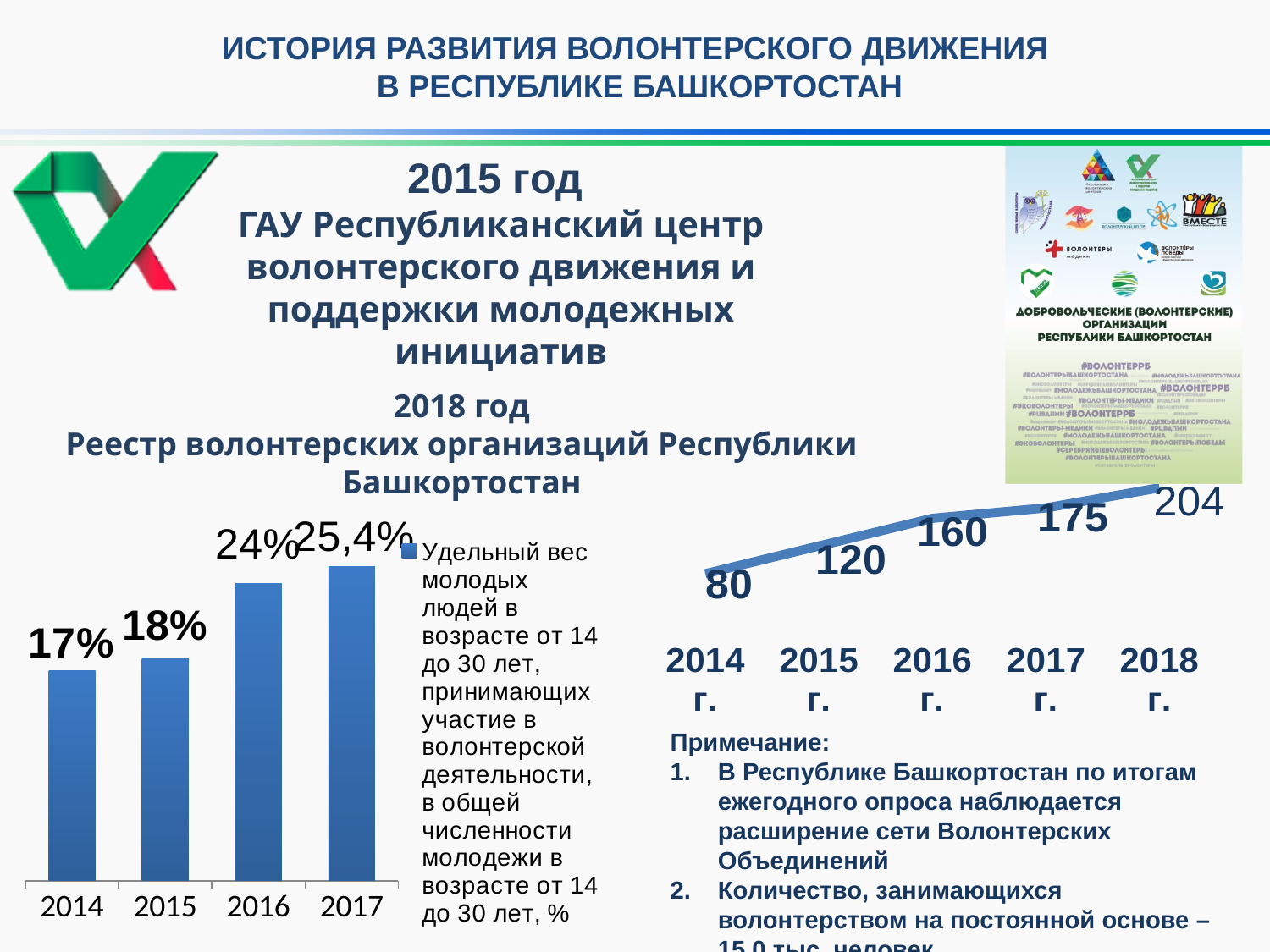
In the bar chart on the left of the slide, what is the value for 2016? 24% In the bar chart on the left of the slide, which year has the lowest value? 2014 In the line chart on the right of the slide, what is the value for 2016 г.? 160 In the bar chart on the left of the slide, what is the difference between the values for 2016 and 2015? 6% In the bar chart on the left of the slide, how many years are shown on the x axis? 4 What kind of chart is the chart on the left of the slide? bar chart In the line chart on the right of the slide, what is the difference between the values for 2015 г. and 2014 г.? 40 In the bar chart on the left of the slide, what is the value for 2017? 25,4% In the line chart on the right of the slide, do the values rise or fall from 2014 г. to 2018 г.? rise In the bar chart on the left of the slide, which year has the highest value? 2017 In the line chart on the right of the slide, how many data points are plotted? 5 In the line chart on the right of the slide, what is the value for 2018 г.? 204